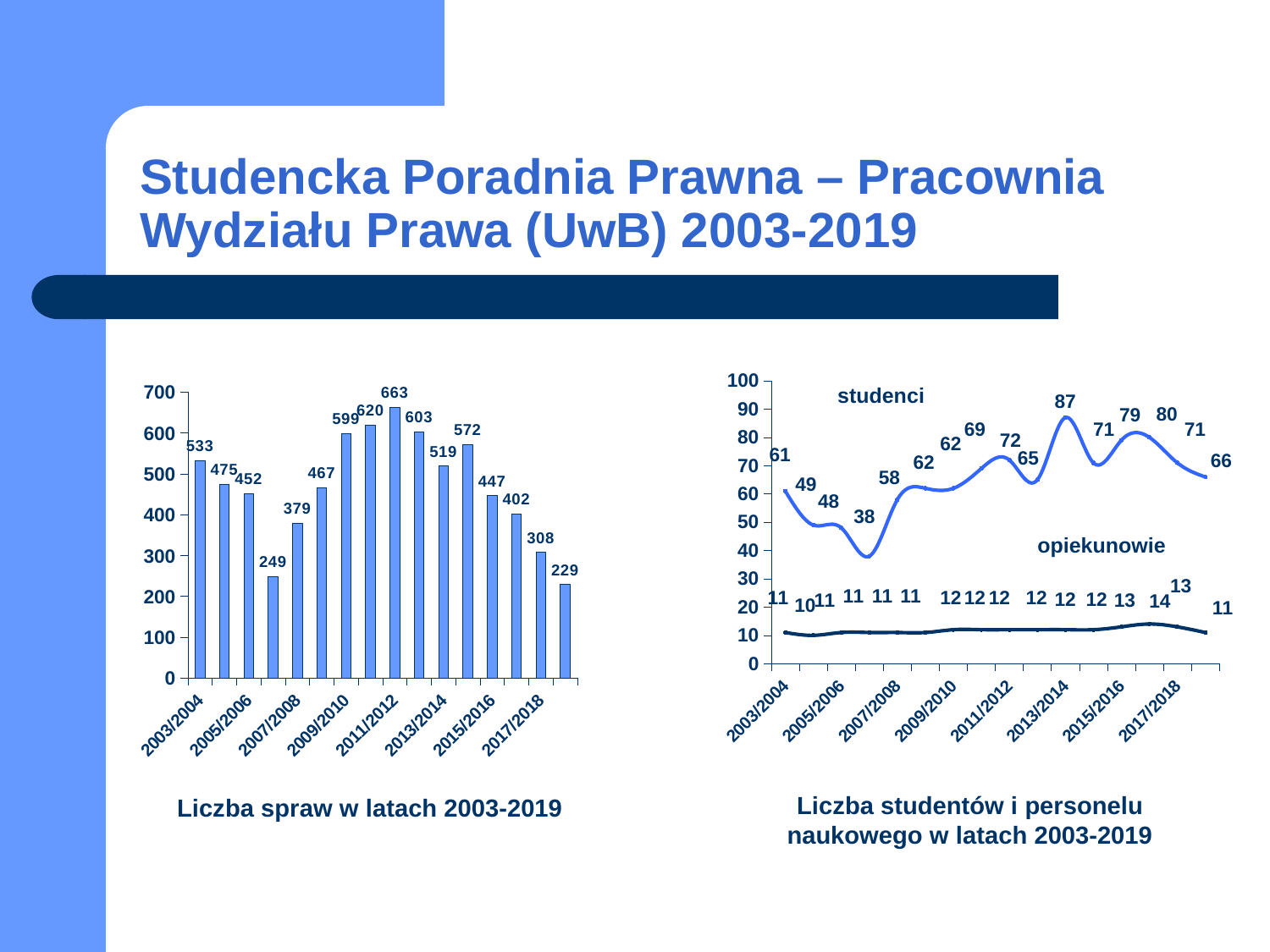
In the left chart 'Liczba spraw w latach 2003-2019', what is the value for 2007/2008? 379 What kind of chart is the left chart 'Liczba spraw w latach 2003-2019'? bar chart In the left chart 'Liczba spraw w latach 2003-2019', how many bars are plotted? 16 In the left chart 'Liczba spraw w latach 2003-2019', what is the lowest value shown? 229 In the left chart 'Liczba spraw w latach 2003-2019', what is the difference between the values for 2003/2004 and 2005/2006? 81 In the left chart 'Liczba spraw w latach 2003-2019', what is the value for 2003/2004? 533 In the left chart 'Liczba spraw w latach 2003-2019', what is the highest value shown? 663 In the right chart 'Liczba studentów i personelu naukowego w latach 2003-2019', what is the studenci value for 2013/2014? 87 In the right chart 'Liczba studentów i personelu naukowego w latach 2003-2019', how many series are plotted? 2 In the right chart 'Liczba studentów i personelu naukowego w latach 2003-2019', what is the lowest studenci value? 38 In the right chart 'Liczba studentów i personelu naukowego w latach 2003-2019', which year has the larger studenci value, 2003/2004 or 2005/2006? 2003/2004 In the right chart 'Liczba studentów i personelu naukowego w latach 2003-2019', what is the highest opiekunowie value? 14